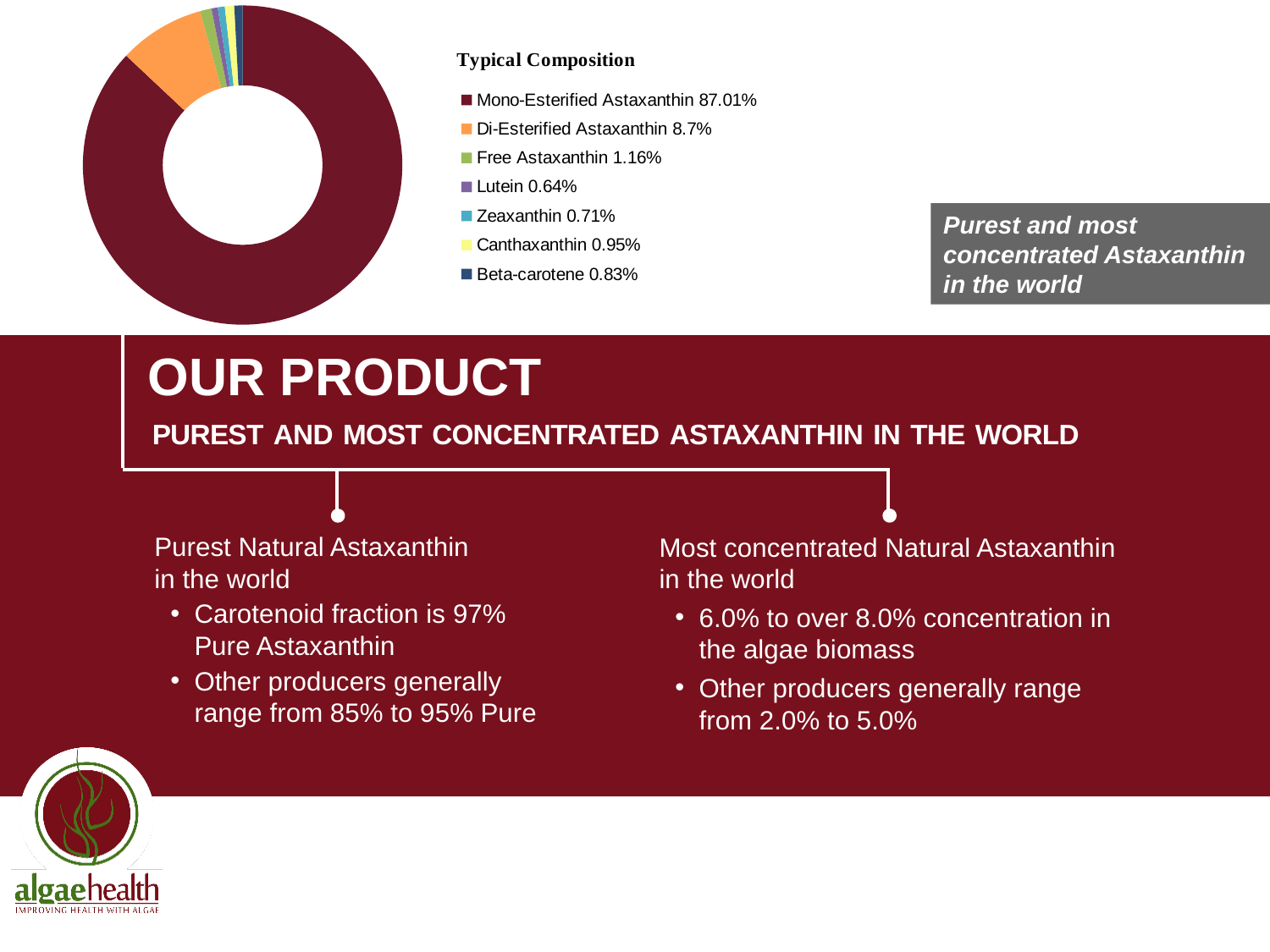
How many components are listed in the Typical Composition chart's legend? 7 What kind of chart is shown under the title "Typical Composition"? Pie chart (doughnut) Which component has the largest share in the Typical Composition chart? Mono-Esterified Astaxanthin What is the value for Lutein in the Typical Composition chart? 0.64% Which component has the smallest share in the Typical Composition chart? Lutein What is the title of the pie chart on the slide? Typical Composition In the Typical Composition chart, which is larger: Canthaxanthin or Beta-carotene? Canthaxanthin What is the difference between the Mono-Esterified Astaxanthin and Di-Esterified Astaxanthin values in the Typical Composition chart? 78.31% What is the value for Free Astaxanthin in the Typical Composition chart? 1.16% What is the value for Beta-carotene in the Typical Composition chart? 0.83% What is the value for Di-Esterified Astaxanthin in the Typical Composition chart? 8.7% What is the value for Mono-Esterified Astaxanthin in the Typical Composition chart? 87.01%